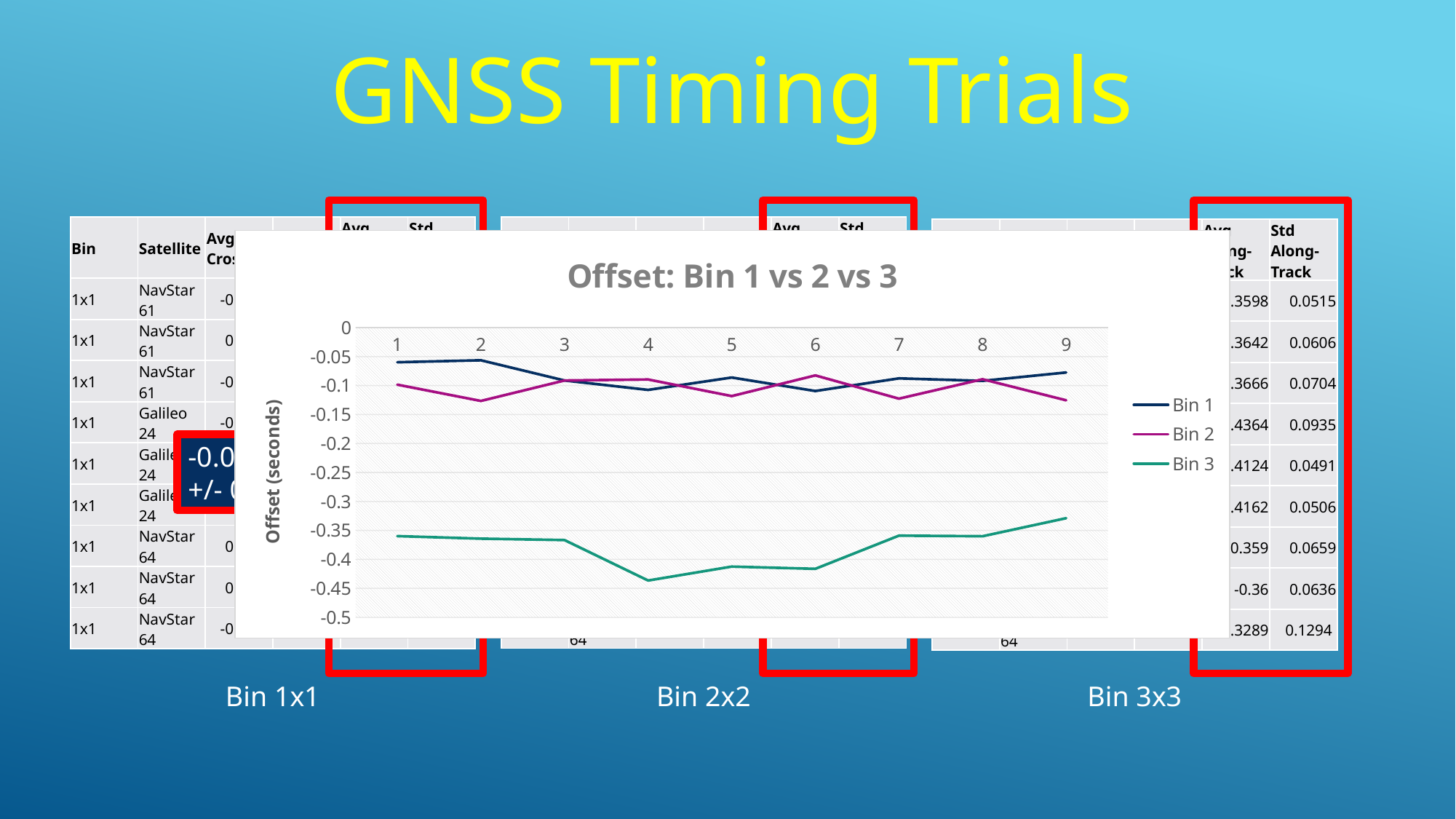
Is the value for Bin 1 at point 1 greater or less than -0.1? greater What is the label of the chart's vertical axis? Offset (seconds) At point 5, which series has the larger value, Bin 1 or Bin 3? Bin 1 How many points are plotted along the x axis for each series? 9 Does the Bin 3 series rise or fall from point 4 to point 9? rise Which series has the lowest offset values across the chart? Bin 3 Is the value for Bin 3 at point 9 greater or less than -0.35? greater At which x-axis point does the Bin 3 series reach its lowest value? 4 What is the title of the chart? Offset: Bin 1 vs 2 vs 3 What kind of chart is shown on the slide? line chart How many series does the chart's legend list? 3 Is the value for Bin 3 at point 4 greater or less than -0.4? less